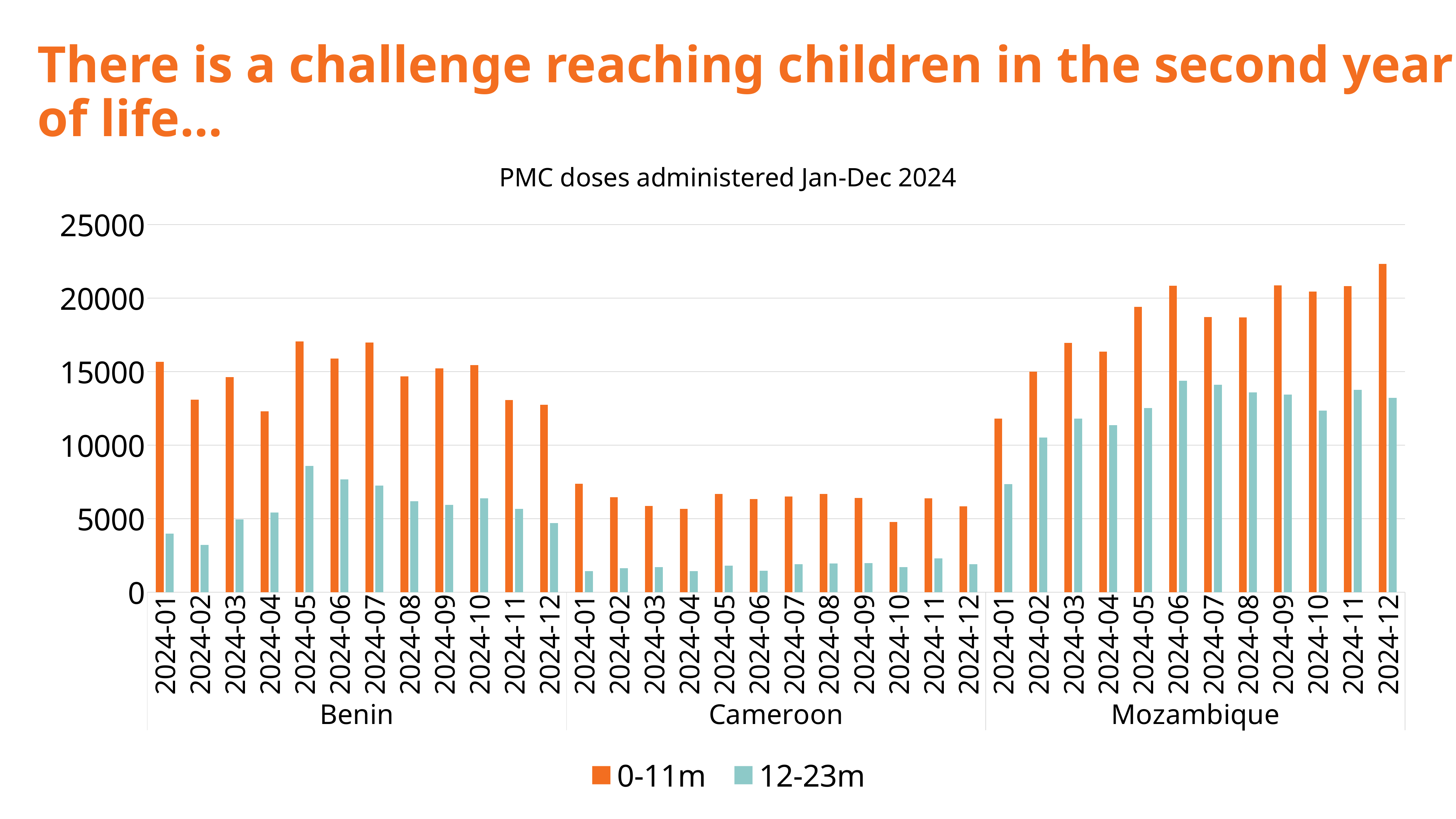
Is the 12-23m value for Mozambique 2024-06 greater or less than 10000? greater How many month categories are plotted across the three countries? 36 Is the 12-23m value for Benin 2024-01 greater or less than 5000? less How many series does the legend list? 2 What is the title of the chart? PMC doses administered Jan-Dec 2024 Is the 0-11m value for Cameroon 2024-01 greater or less than 10000? less Do the 0-11m values for Mozambique generally rise or fall from 2024-01 to 2024-12? rise What kind of chart is shown on the slide? Bar chart Which country and month has the highest 0-11m value? Mozambique 2024-12 Which is larger, the 0-11m value for Benin 2024-05 or the 0-11m value for Cameroon 2024-05? Benin 2024-05